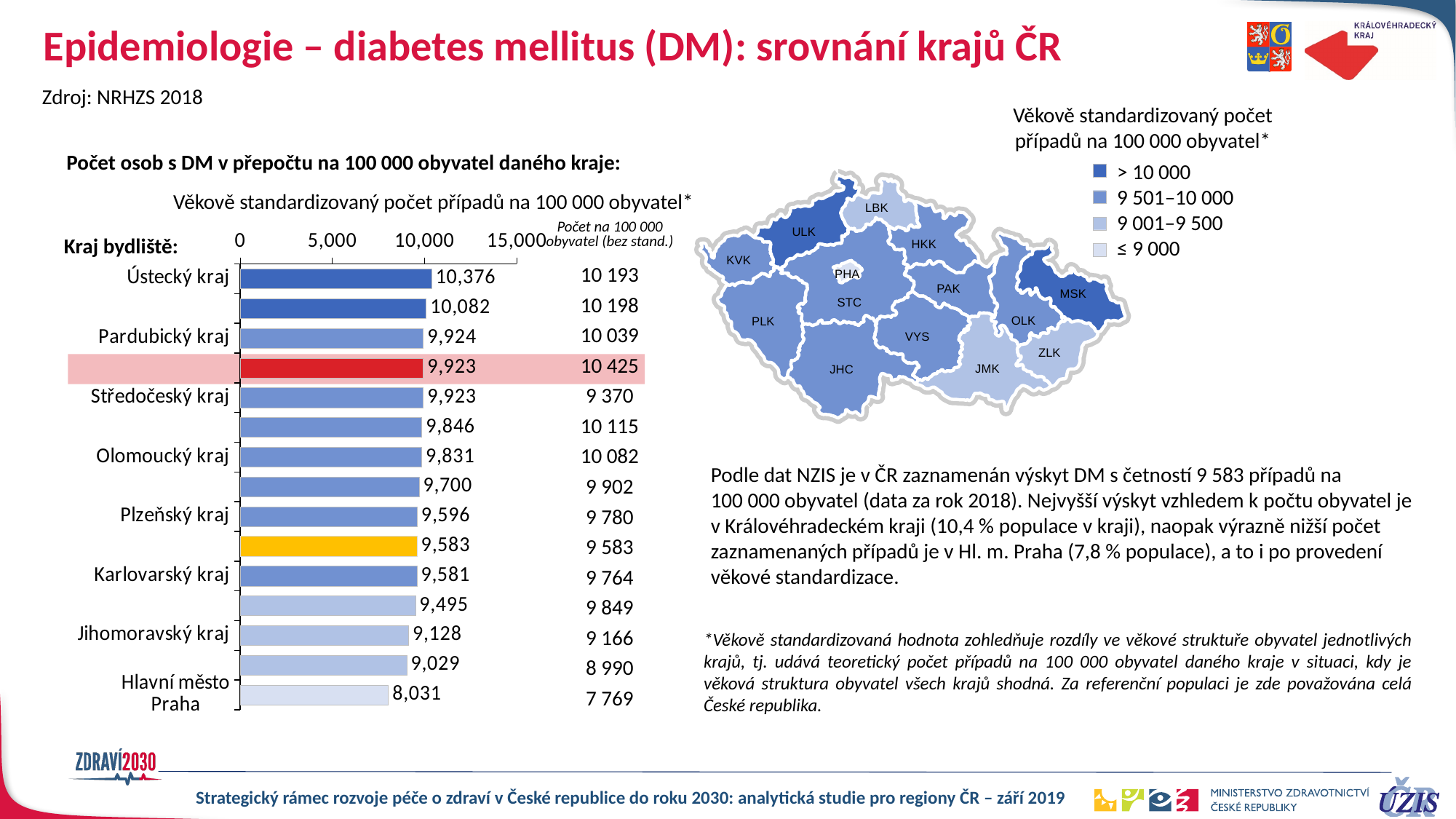
What is the value shown for Karlovarský kraj in the bar chart? 9,581 What is the title printed above the bar chart? Věkově standardizovaný počet případů na 100 000 obyvatel* How many bars are plotted in the bar chart? 15 Which region has the highest value in the bar chart? Ústecký kraj What is the value shown for Hlavní město Praha in the bar chart? 8,031 Which has a larger value in the bar chart, Pardubický kraj or Olomoucký kraj? Pardubický kraj What is the difference between the values for Ústecký kraj and Hlavní město Praha in the bar chart? 2,345 What is the value shown for Jihomoravský kraj in the bar chart? 9,128 Is the value for Hlavní město Praha in the bar chart greater or less than 10,000? less What is the age-standardized number of cases per 100,000 inhabitants for Ústecký kraj in the bar chart? 10,376 Which region has the lowest value in the bar chart? Hlavní město Praha What type of chart is used to show the number of cases per 100,000 inhabitants by region? bar chart